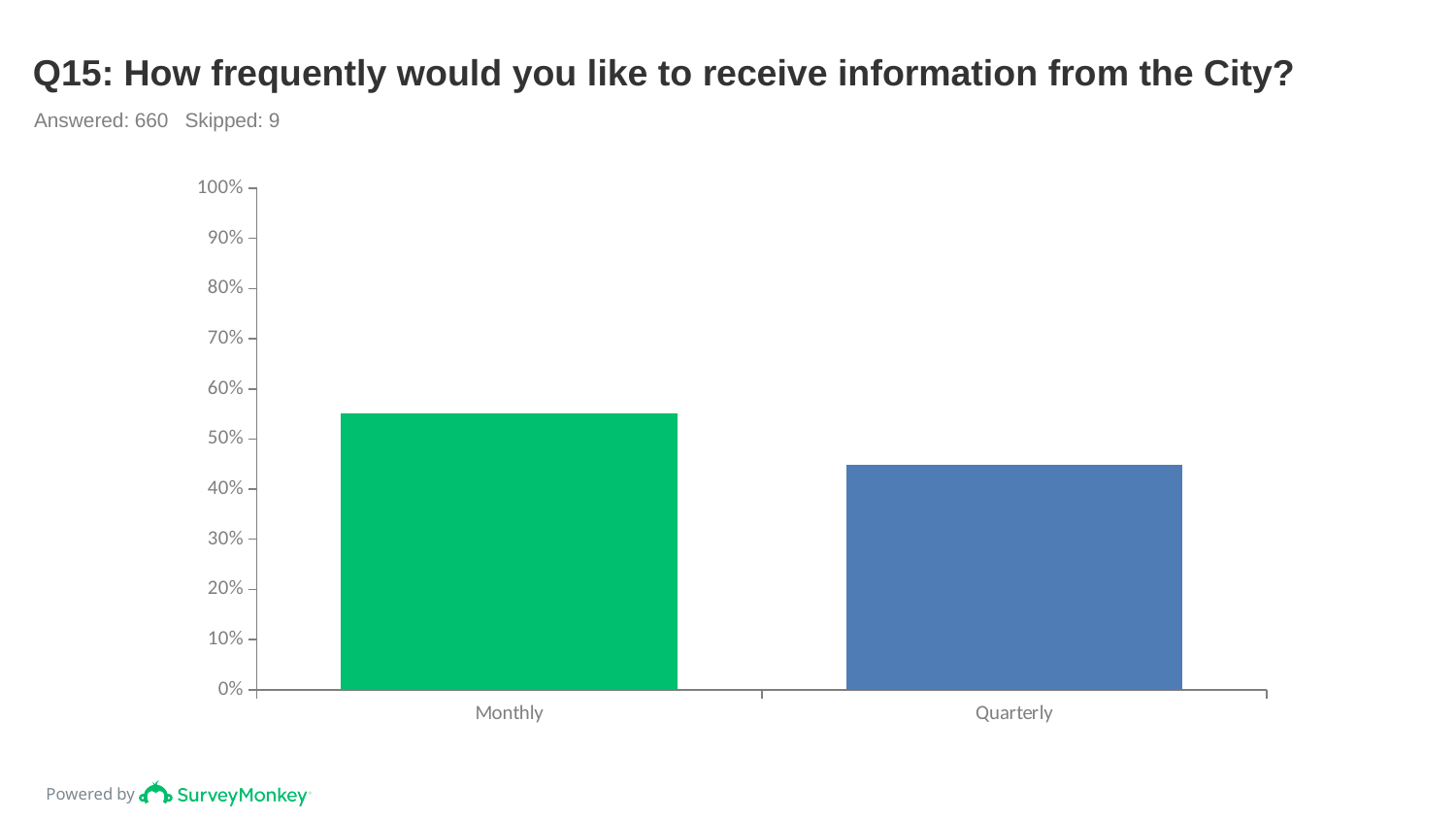
What is the title of the chart? Q15: How frequently would you like to receive information from the City? Which category has the lowest value? Quarterly What kind of chart is shown on the slide? bar chart How many categories are shown on the x axis? 2 How many respondents answered the question according to the slide? 660 Is the value for Quarterly greater or less than 40%? greater Is the value for Quarterly greater or less than 50%? less Which category has the highest value? Monthly Which is larger, the value for Monthly or the value for Quarterly? Monthly Is the value for Monthly greater or less than 60%? less